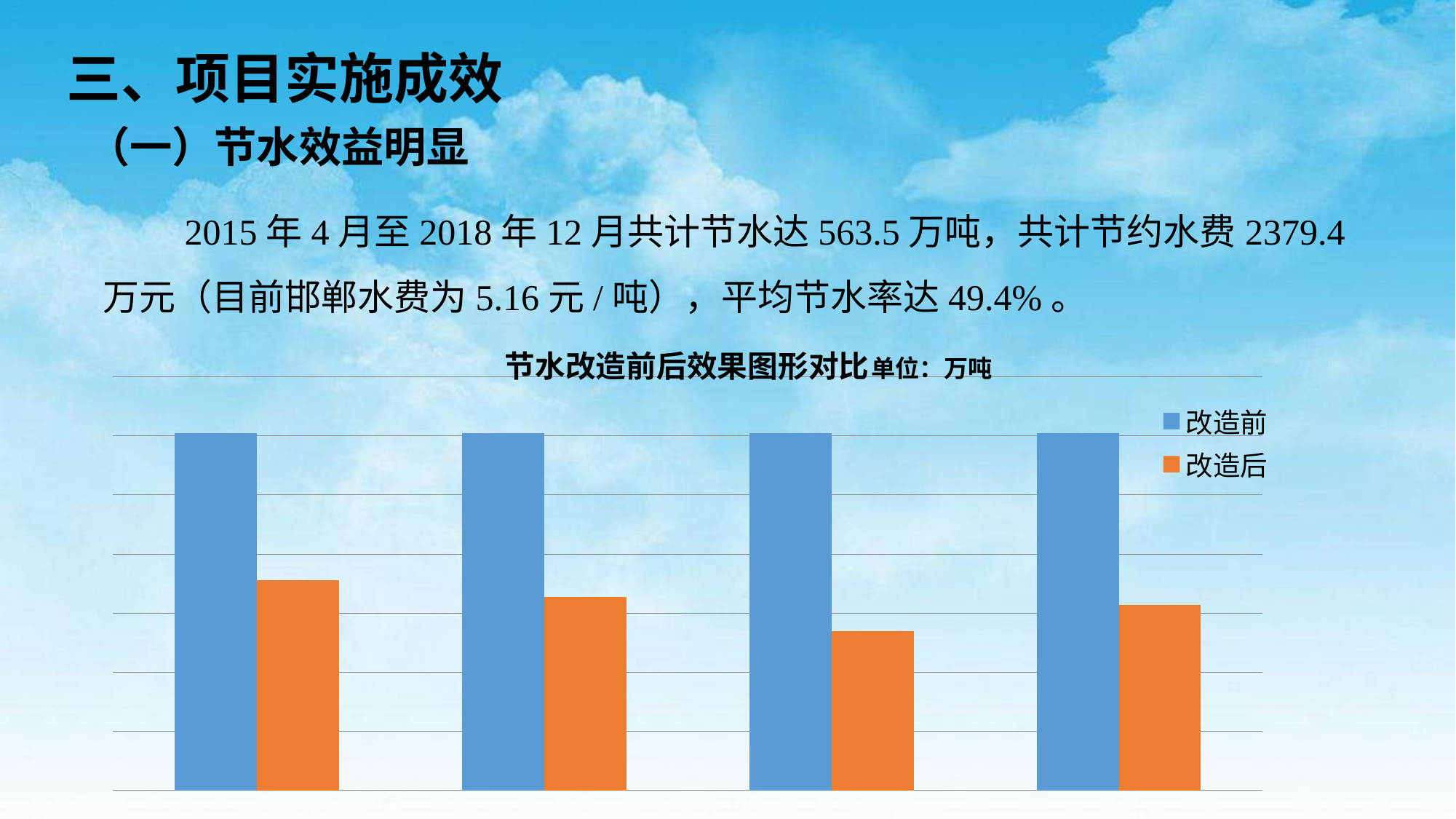
What are the two series named in the chart legend? 改造前 and 改造后 How many series does the chart legend list? 2 What is the title of the chart? 节水改造前后效果图形对比 Is the 改造后 bar in the fourth group larger or smaller than the 改造前 bar in the same group? smaller What kind of chart is shown on the slide? bar chart Which group of bars, counting from the left, has the lowest 改造后 value? the third group In the third group of bars from the left, which series has the smaller value, 改造前 or 改造后? 改造后 Across all four groups, is the 改造后 value ever greater than the 改造前 value? No How many groups of bars (categories) are plotted in the chart? 4